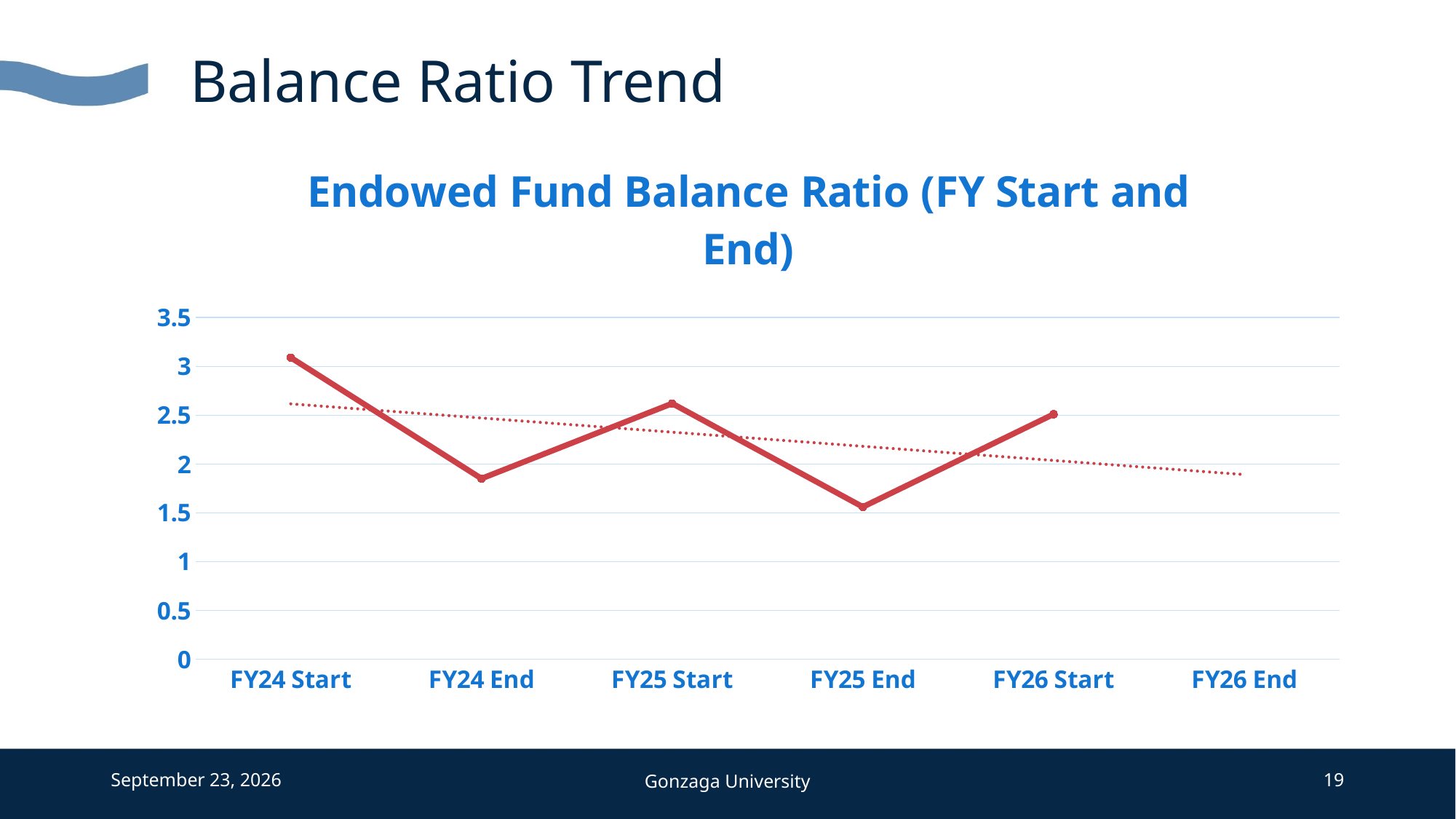
What is the title of the chart? Endowed Fund Balance Ratio (FY Start and End) What kind of chart is shown on the slide? Line chart Is the value for FY24 End greater or less than 2? less Which is larger, the value for FY24 Start or the value for FY25 Start? FY24 Start Is the value for FY26 Start greater or less than 2? greater How many categories are labelled on the x axis of the chart? 6 Which category has the highest balance ratio? FY24 Start Is the value for FY24 Start greater or less than 3? greater Does the dotted trendline rise or fall from left to right? Fall Which is larger, the value for FY24 End or the value for FY25 End? FY24 End Which category has the lowest balance ratio? FY25 End